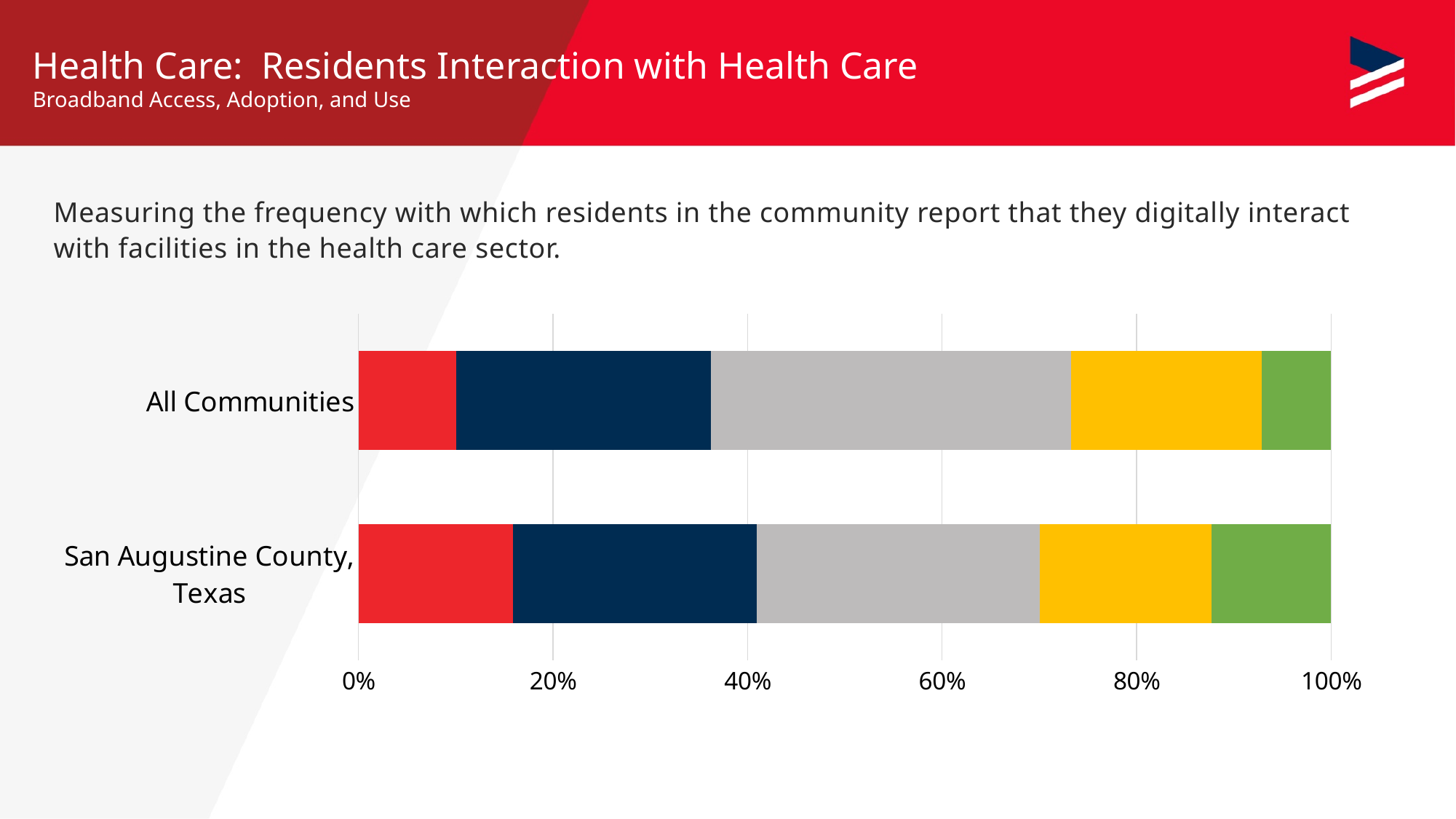
How many categories (bars) are plotted in the chart? 2 Is the red segment for All Communities greater or less than 20% of the bar? less What is the highest value shown on the horizontal axis of the chart? 100% Which category is listed at the top of the chart? All Communities Which bar has the larger red segment, All Communities or San Augustine County, Texas? San Augustine County, Texas How many coloured segments make up each bar in the chart? 5 Is the grey segment for All Communities greater or less than 20% of the bar? greater Is the dark navy segment for San Augustine County, Texas greater or less than 20% of the bar? greater Which bar has the larger green segment, All Communities or San Augustine County, Texas? San Augustine County, Texas What kind of chart is shown on the slide? Stacked bar chart Which bar has the larger grey segment, All Communities or San Augustine County, Texas? All Communities